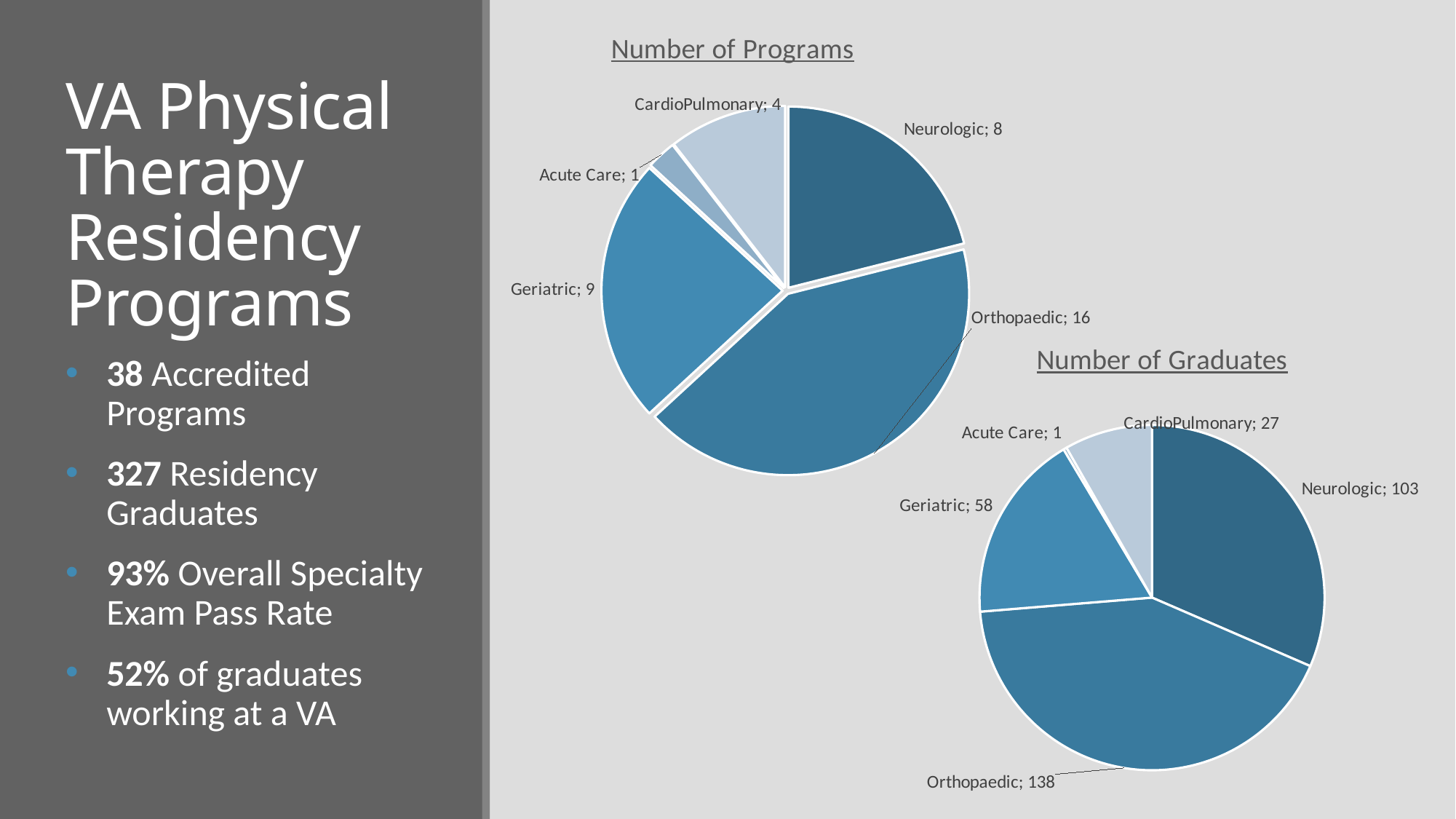
How many categories does the Number of Programs chart show? 5 What is the title of the chart in the upper part of the slide? Number of Programs What type of chart is the Number of Graduates chart? Pie chart In the Number of Programs chart, how many programs are Geriatric? 9 In the Number of Programs chart, which specialty has the most programs? Orthopaedic In the Number of Graduates chart, how many graduates are Neurologic? 103 In the Number of Graduates chart, what is the difference between Orthopaedic and Neurologic graduates? 35 In the Number of Programs chart, what is the difference between Geriatric and CardioPulmonary programs? 5 In the Number of Graduates chart, how many graduates are CardioPulmonary? 27 In the Number of Graduates chart, which has more graduates, Geriatric or CardioPulmonary? Geriatric In the Number of Graduates chart, which specialty has the fewest graduates? Acute Care In the Number of Programs chart, how many programs are Orthopaedic? 16